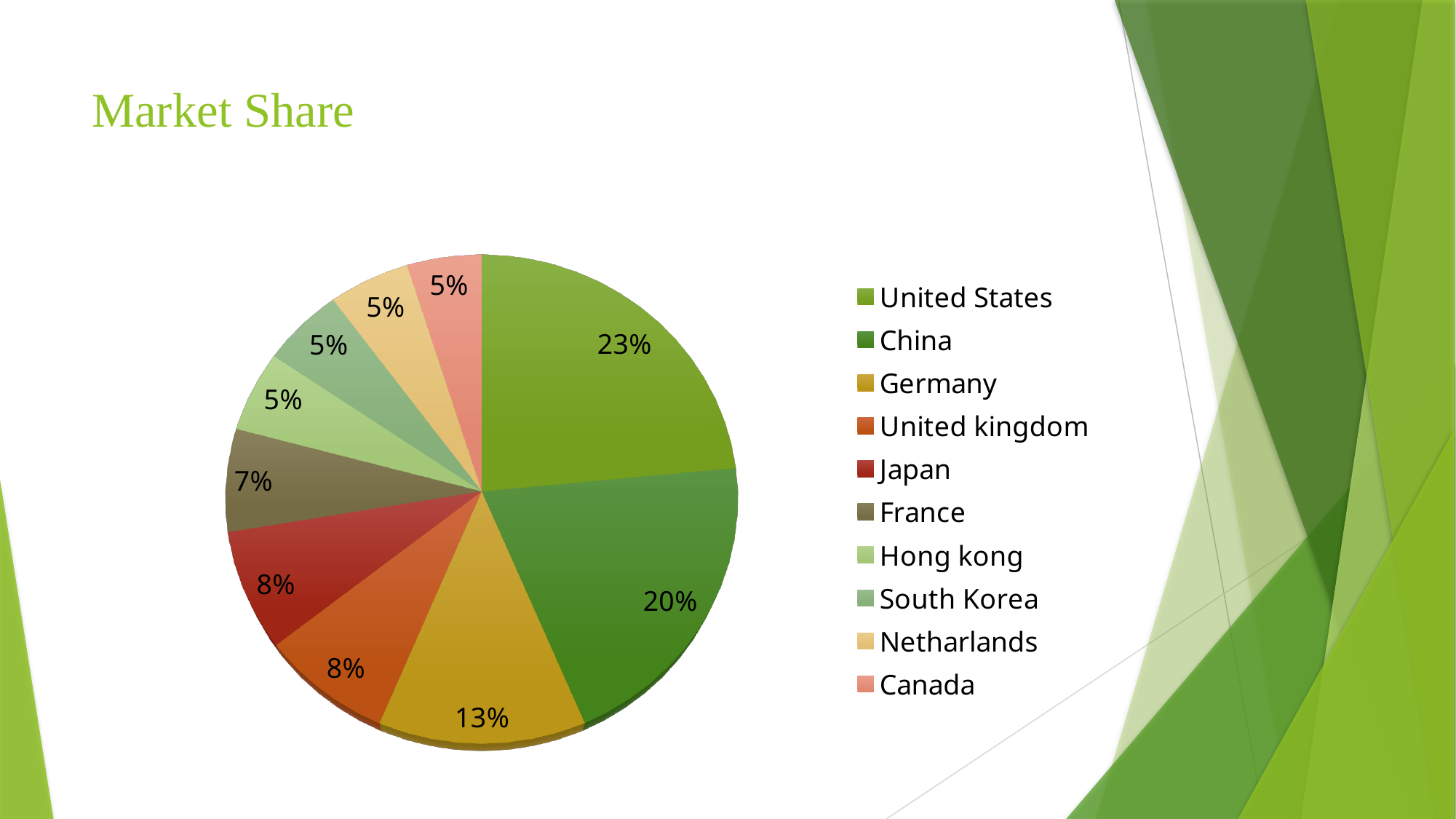
What share of the pie does China hold? 20% What is the combined share of the United Kingdom and Japan? 16% Which is larger, the share for Germany or the share for Japan? Germany What type of chart is shown on the slide? pie chart What is the value shown for Germany? 13% What share of the pie does the United States hold? 23% What is the value shown for France? 7% Which country has the largest share of the pie? United States What is the title of the chart on the slide? Market Share How many countries have a share of 5%? 4 What is the difference between the shares of the United States and China? 3% How many countries are listed in the legend? 10